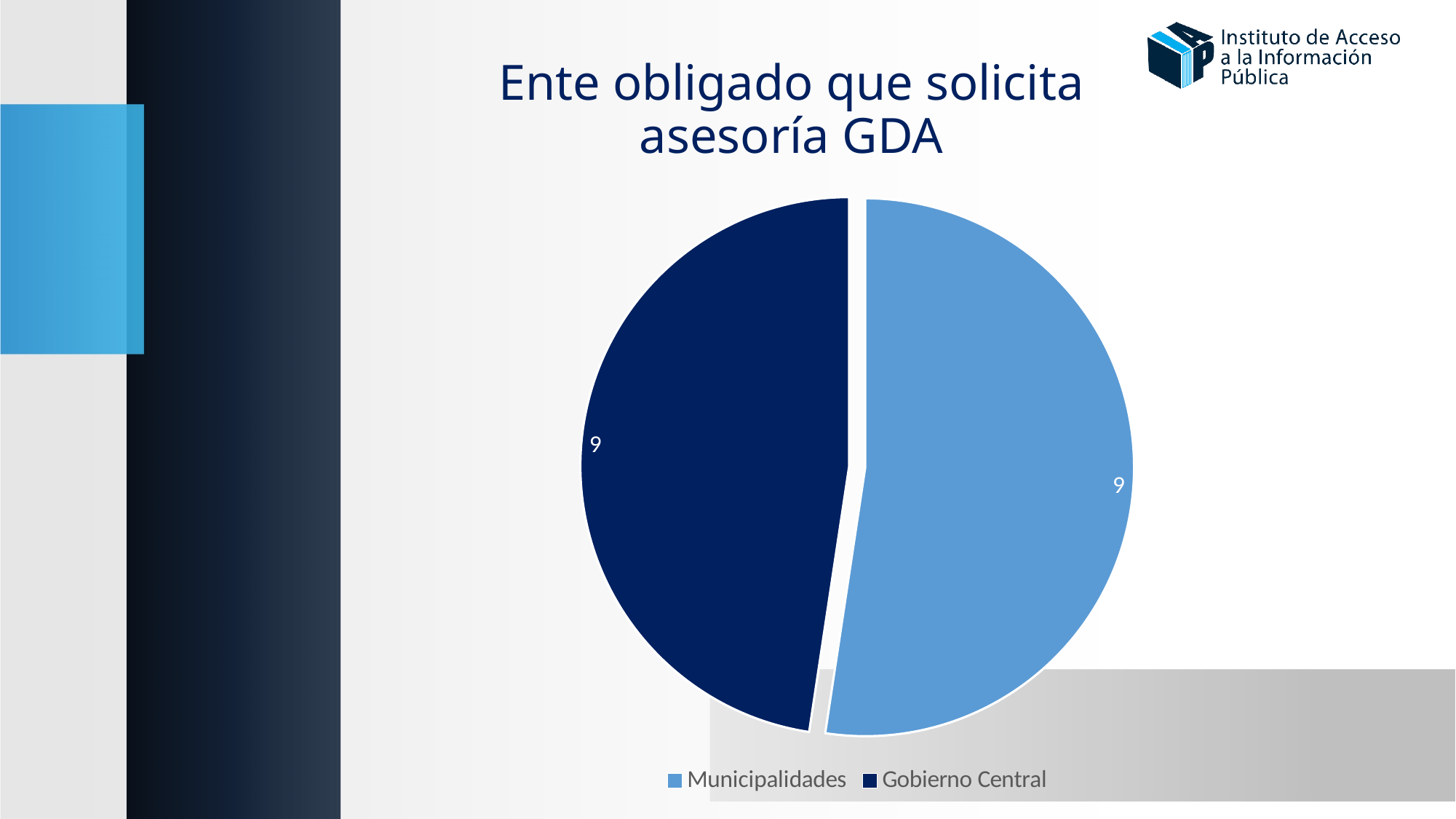
What is the value for Gobierno Central? 9 Which legend entry is shown in dark navy blue? Gobierno Central How many entries does the legend list? 2 What kind of chart is shown on the slide? pie chart What is the value for Municipalidades? 9 What is the title of the chart? Ente obligado que solicita asesoría GDA What is the total of all slices in the pie chart? 18 How many slices does the pie chart have? 2 What is the difference between the values for Municipalidades and Gobierno Central? 0